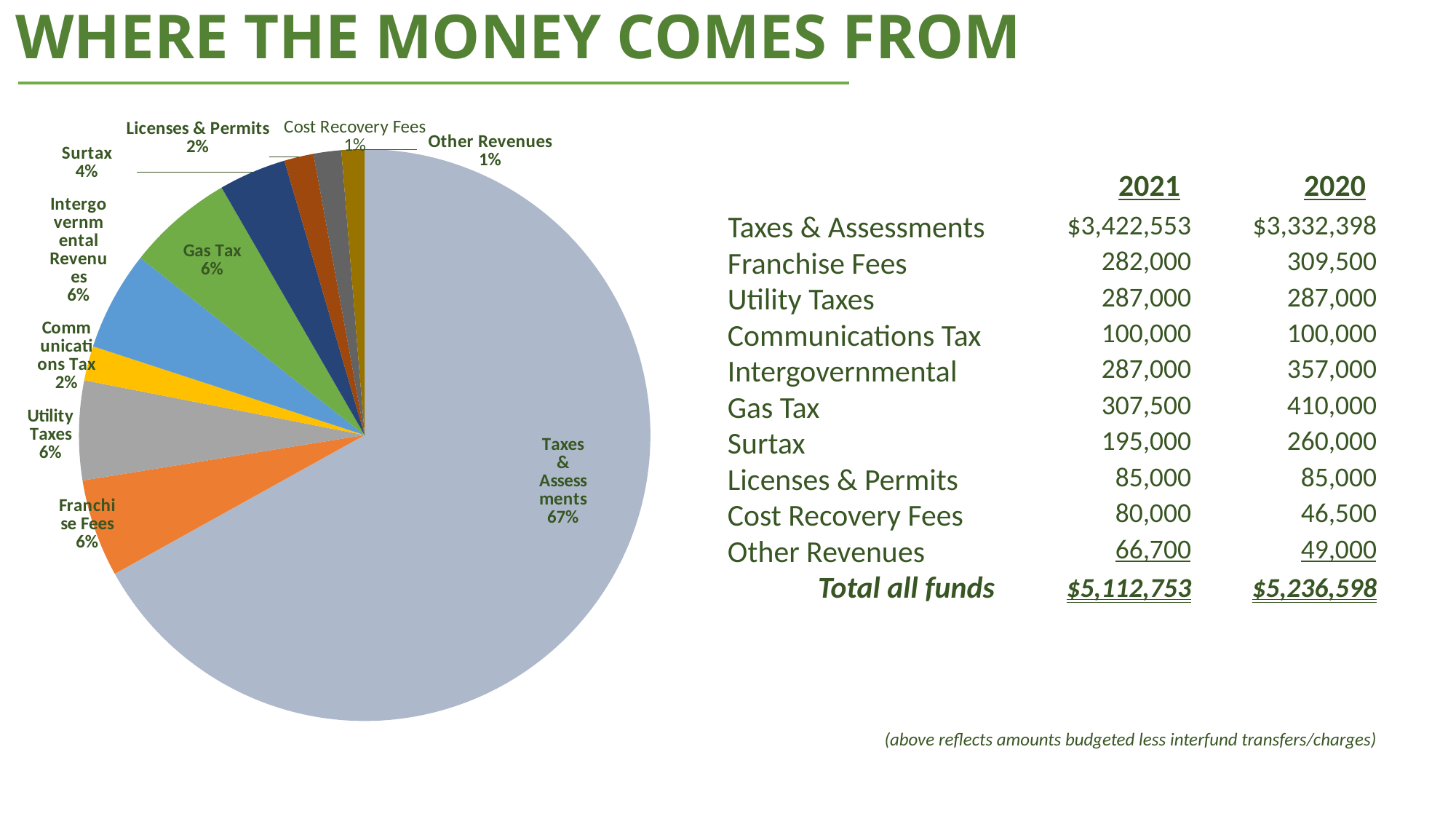
What percentage is shown for Surtax in the pie chart? 4% Which slice of the pie chart is the largest? Taxes & Assessments What kind of chart is shown on the slide? Pie chart What is the difference in percentage points between Gas Tax and Surtax in the pie chart? 2 What is the difference in percentage points between Taxes & Assessments and Franchise Fees in the pie chart? 61 What percentage is shown for Licenses & Permits in the pie chart? 2% What percentage is shown for Gas Tax in the pie chart? 6% What is the title of the slide containing the pie chart? WHERE THE MONEY COMES FROM How many slices does the pie chart have? 10 Which is larger in the pie chart, Surtax or Communications Tax? Surtax What share of the pie does Taxes & Assessments represent? 67% What percentage is shown for Cost Recovery Fees in the pie chart? 1%